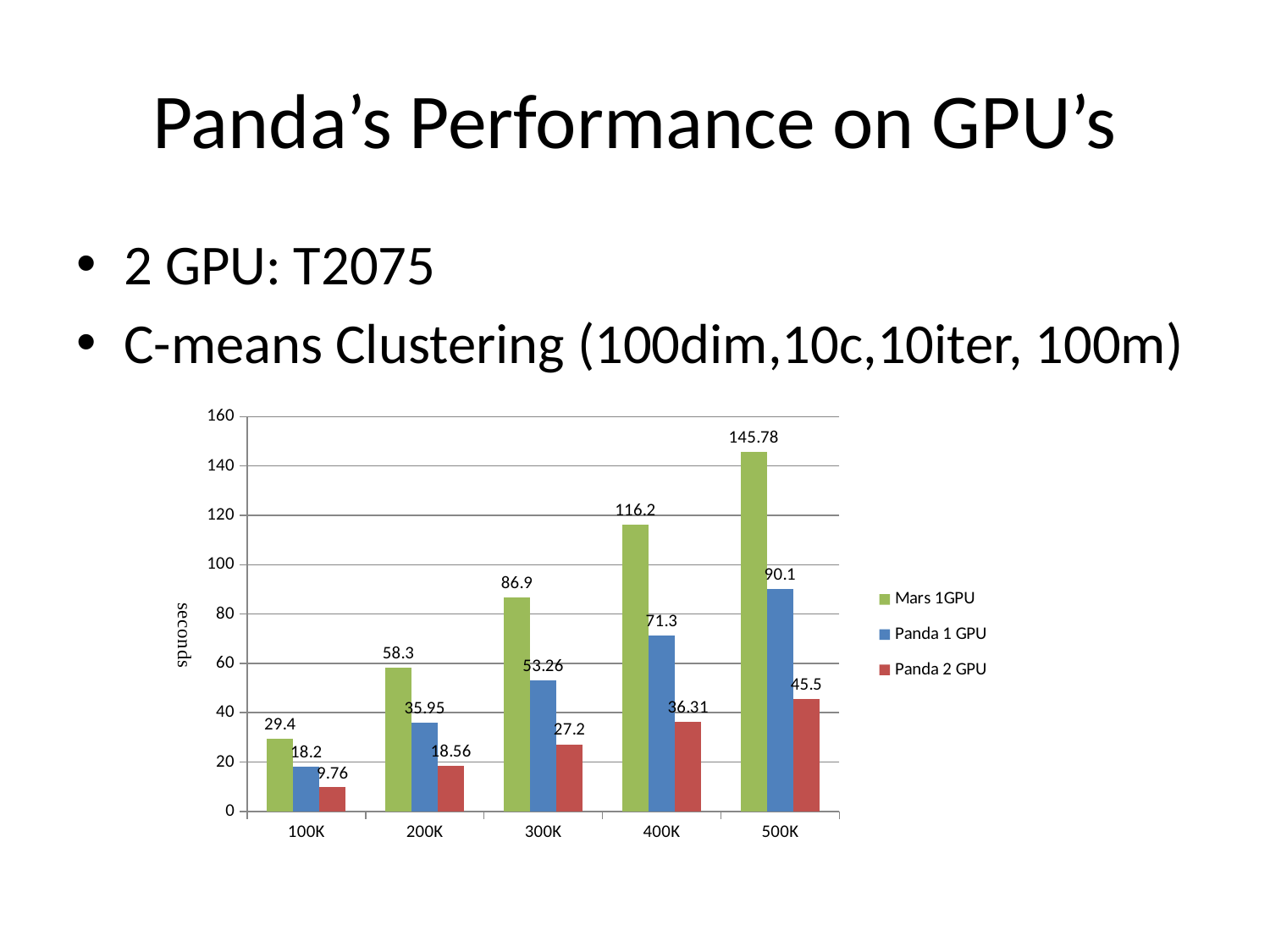
Which is larger: Panda 1 GPU at 200K or Panda 2 GPU at 300K? Panda 1 GPU at 200K What is the difference between Mars 1GPU and Panda 1 GPU at 500K? 55.68 What is the value for Panda 2 GPU at 100K? 9.76 What kind of chart is shown on the slide? bar chart What is the value for Mars 1GPU at 500K? 145.78 Which category has the lowest value for Panda 2 GPU? 100K Is the value for Mars 1GPU at 400K greater or less than 100? greater What is the value for Panda 1 GPU at 300K? 53.26 How many categories are shown on the x axis? 5 Do the Panda 2 GPU values rise or fall as the x axis goes from 100K to 500K? rise Which series has the highest value at 400K? Mars 1GPU How many series does the legend list? 3